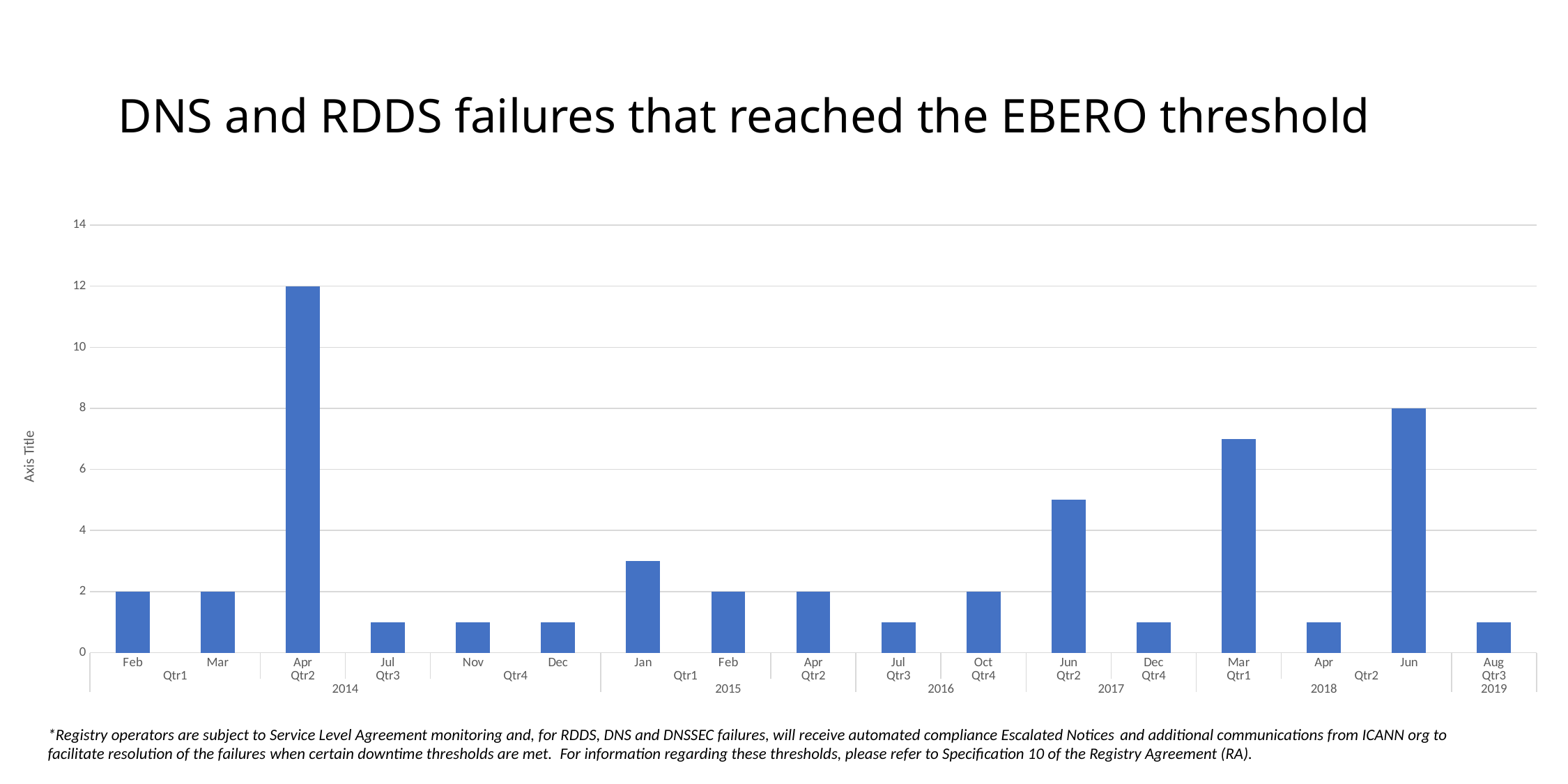
What is the value for Apr 2014 (Qtr2)? 12 Is the value for Mar 2018 greater or less than 6? greater What is the value for Jun 2018 (Qtr2)? 8 How many bars are plotted in the chart? 17 What is the value for Feb 2014 (Qtr1)? 2 What type of chart is shown on the slide? Bar chart Which month has the highest number of failures in the chart? Apr 2014 Is the value for Jun 2017 greater or less than 4? greater Is the value for Jul 2014 greater or less than 2? less What is the difference between the values for Apr 2014 and Jun 2018? 4 What is the title of the chart? DNS and RDDS failures that reached the EBERO threshold Which is larger, the value for Mar 2018 or the value for Jun 2018? Jun 2018